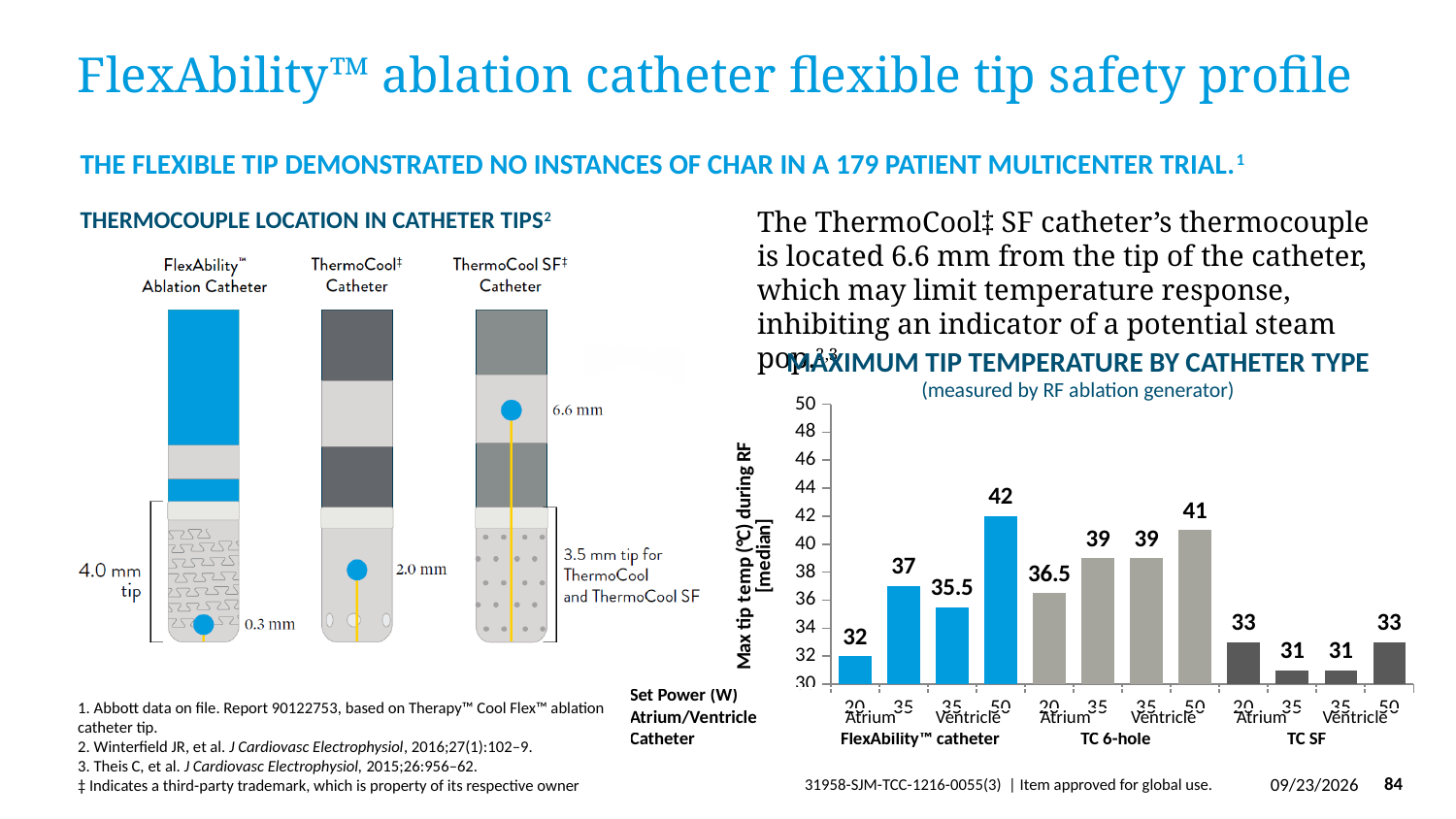
What is the y-axis label of the maximum tip temperature chart? Max tip temp (°C) during RF [median] What is the maximum tip temperature for the TC 6-hole catheter at 20 W in the atrium? 36.5 What is the maximum tip temperature for the TC SF catheter at 35 W in the ventricle? 31 What is the maximum tip temperature for the FlexAbility catheter at 50 W in the ventricle? 42 What is the lowest maximum tip temperature shown in the chart? 31 What is the difference between the FlexAbility catheter's maximum tip temperature at 50 W in the ventricle and the TC SF catheter's at 50 W in the ventricle? 9 Which bar shows the highest maximum tip temperature in the chart? FlexAbility catheter, Ventricle 50 W (42) How many catheter types are compared in the maximum tip temperature chart? 3 What type of chart is used to show maximum tip temperature by catheter type? bar chart How many bars are plotted in the maximum tip temperature chart? 12 What is the maximum tip temperature for the FlexAbility catheter at 20 W in the atrium? 32 Which has a higher maximum tip temperature at 35 W in the atrium: the FlexAbility catheter or the TC 6-hole catheter? TC 6-hole